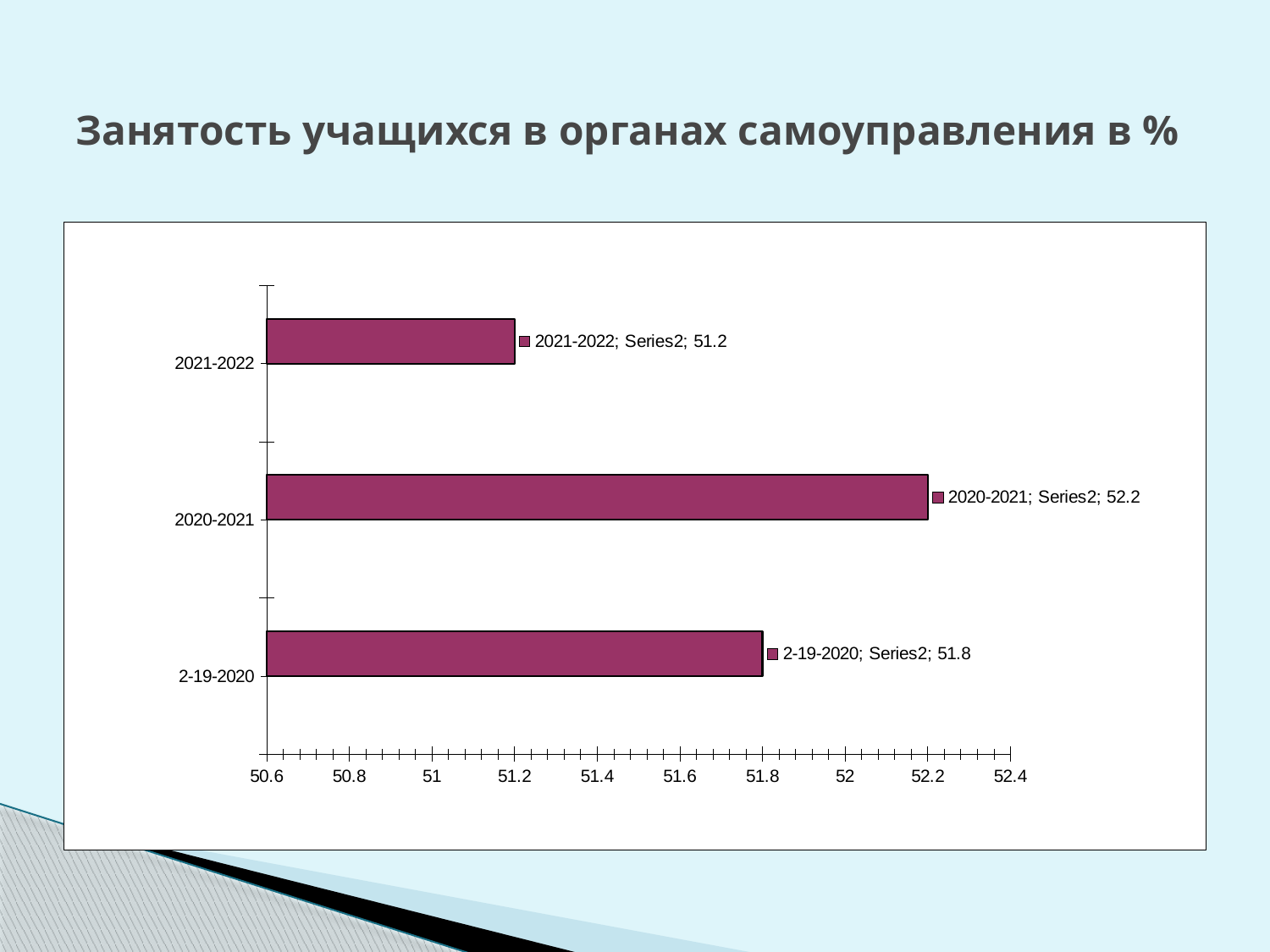
What is the title of the chart on the slide? Занятость учащихся в органах самоуправления в % Which category has the highest value? 2020-2021 What is the value for 2-19-2020? 51.8 How many categories are shown in the chart? 3 Which is larger, the value for 2-19-2020 or the value for 2021-2022? 2-19-2020 What is the difference between the values for 2020-2021 and 2021-2022? 1 What is the value for 2020-2021? 52.2 Is the value for 2020-2021 greater or less than 52? greater Which category has the lowest value? 2021-2022 What is the value for 2021-2022? 51.2 What is the difference between the values for 2-19-2020 and 2021-2022? 0.6 What kind of chart is shown on the slide? bar chart